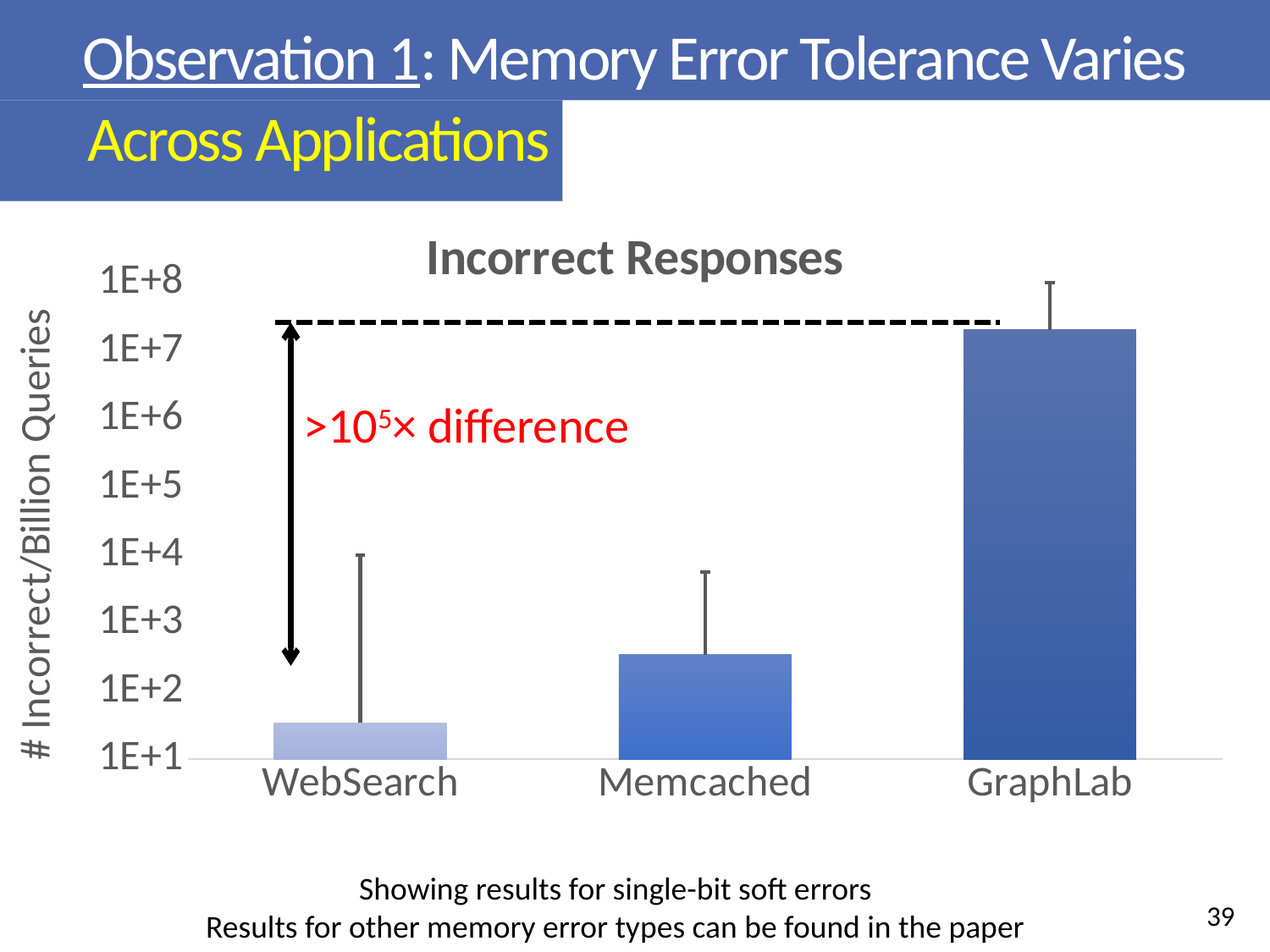
Is the value for WebSearch greater or less than 1E+2? less Is the value for Memcached greater or less than 1E+3? less How many applications (categories) are plotted in the Incorrect Responses chart? 3 What is the label of the y axis? # Incorrect/Billion Queries What type of chart is shown on the slide? bar chart Do the bar values rise or fall moving from WebSearch to GraphLab along the x axis? rise Which application has the lowest number of incorrect responses per billion queries? WebSearch What is the title of the chart? Incorrect Responses Which application has the highest number of incorrect responses per billion queries? GraphLab Is the value for Memcached greater or less than 1E+2? greater Which has more incorrect responses per billion queries, Memcached or WebSearch? Memcached